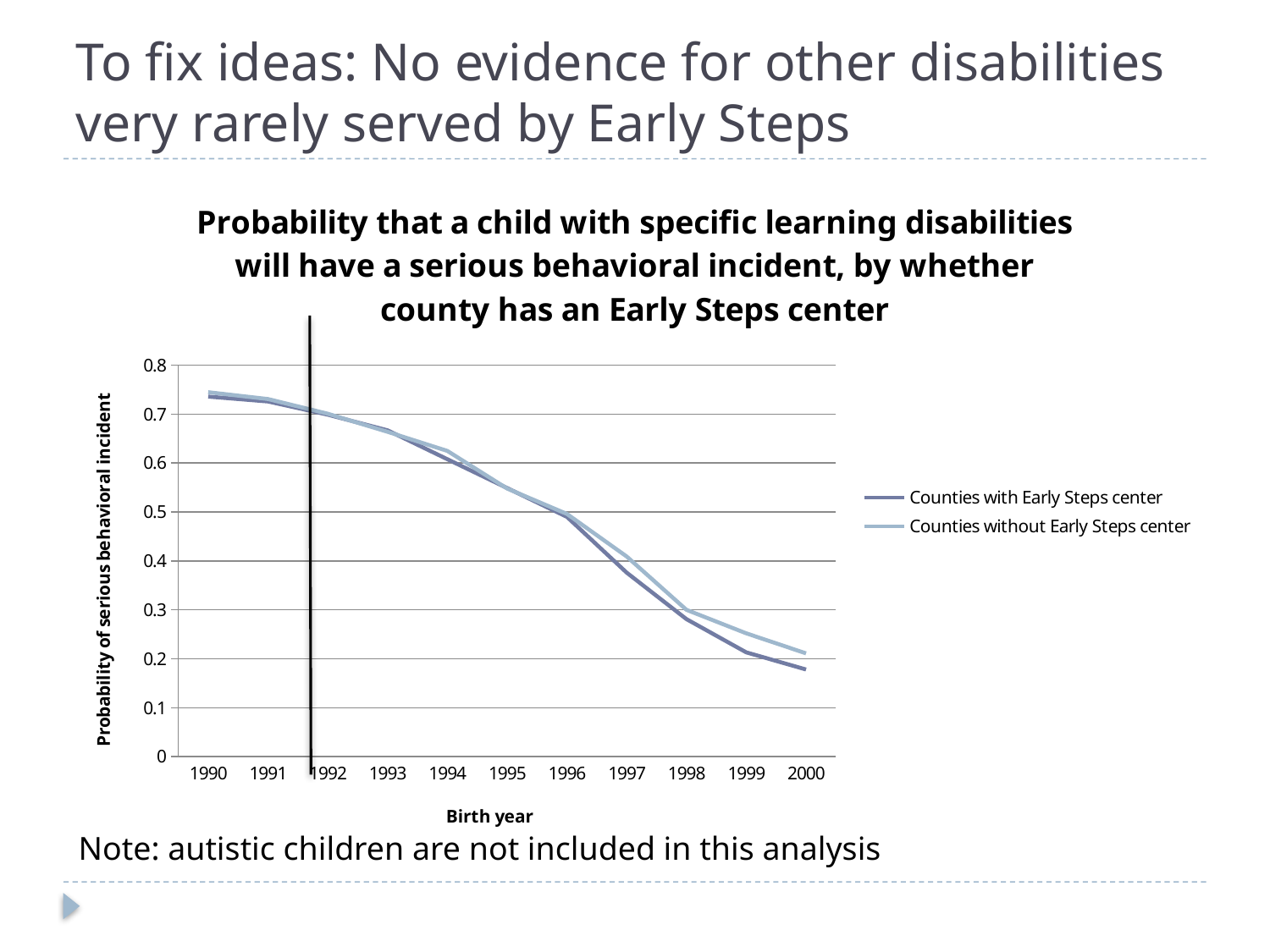
In which birth year is the probability for Counties with Early Steps center lowest? 2000 How many series does the legend list? 2 Do the values for Counties with Early Steps center rise or fall from 1990 to 2000? fall What is the label of the y axis? Probability of serious behavioral incident What kind of chart is shown on the slide? line chart What is the label of the x axis? Birth year Is the value for Counties with Early Steps center in 1998 greater or less than 0.3? less In which birth year is the probability for Counties without Early Steps center highest? 1990 Is the value for Counties with Early Steps center in 1990 greater or less than 0.7? greater Is the value for Counties without Early Steps center in 1994 greater or less than 0.6? greater How many birth years are plotted along the x axis? 11 For birth year 2000, which series has the higher probability? Counties without Early Steps center